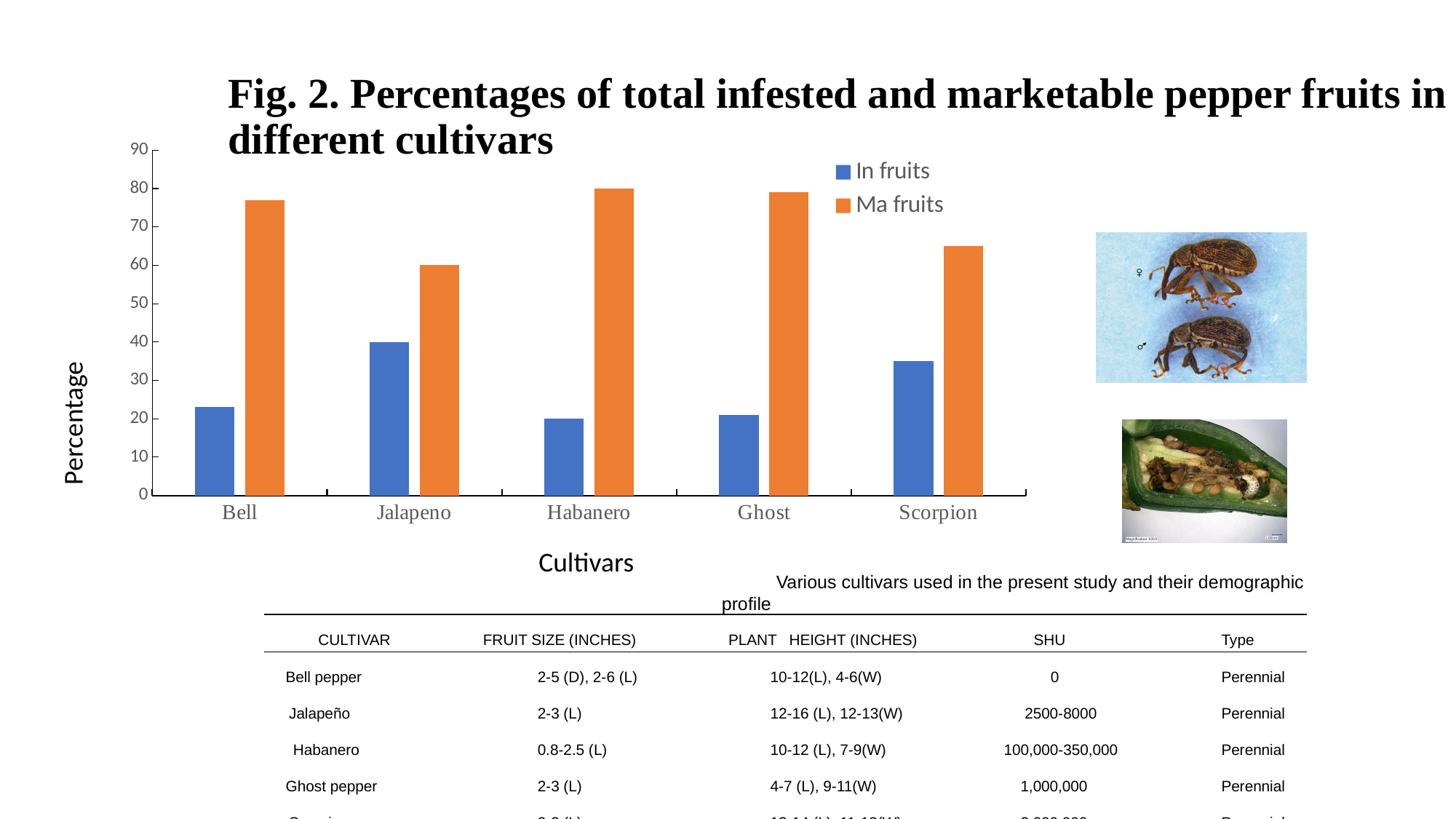
Is the Ma fruits value for Bell greater or less than 70? greater What is the label of the chart's y axis? Percentage Which is larger, the Ma fruits value for Jalapeno or the Ma fruits value for Ghost? Ghost What kind of chart is shown on the slide? bar chart What are the two series named in the chart's legend? In fruits, Ma fruits Which cultivar has the lowest Ma fruits value? Jalapeno Is the In fruits value for Habanero greater or less than 30? less Is the In fruits value for Scorpion greater or less than 30? greater How many series does the chart's legend list? 2 Which is larger, the In fruits value for Bell or the In fruits value for Scorpion? Scorpion How many cultivars are shown on the x axis of the chart? 5 Which cultivar has the highest In fruits value? Jalapeno